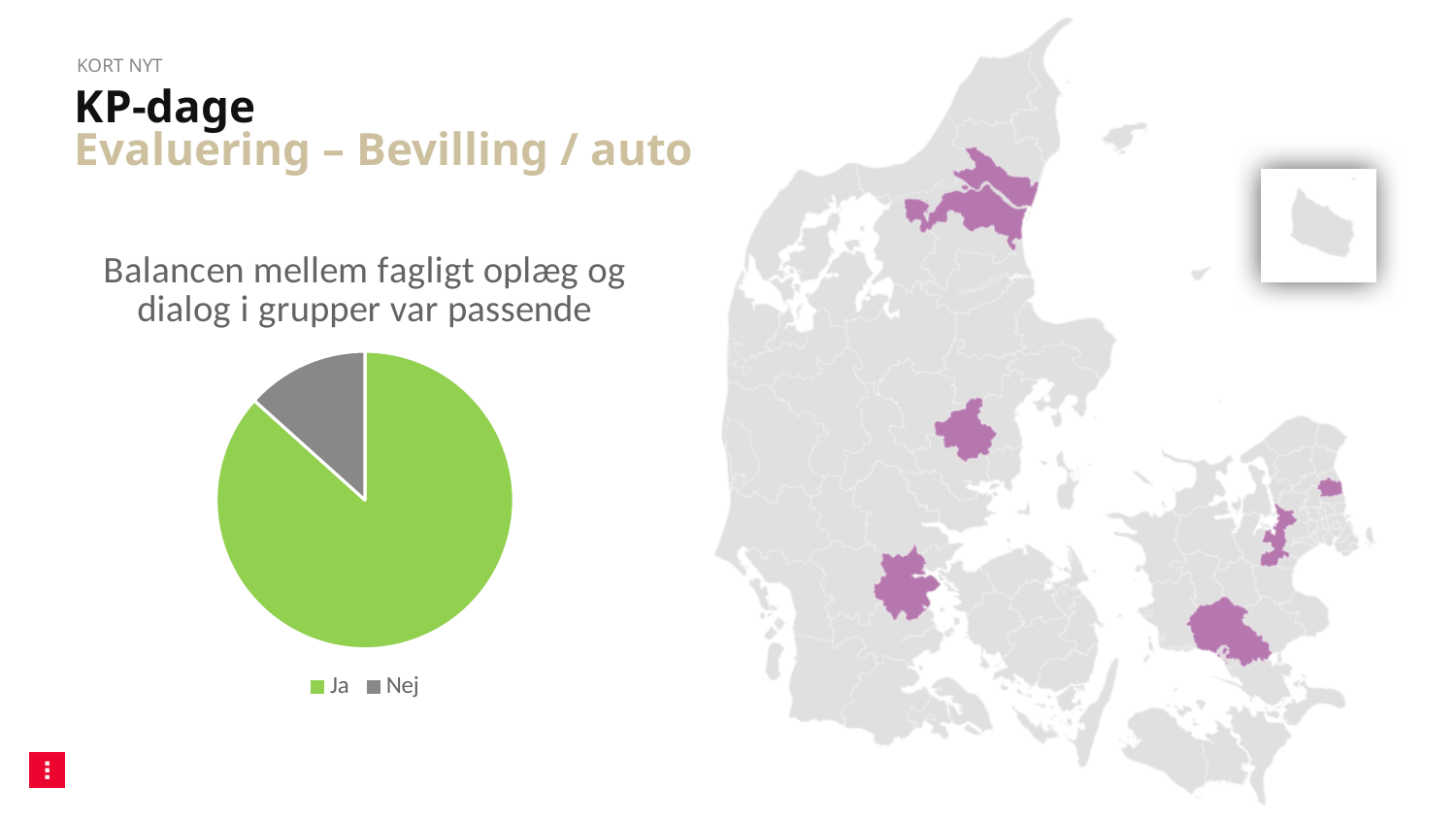
How many slices does the pie chart have? 2 What kind of chart is shown on the slide? Pie chart What colour is the Ja slice in the pie chart? Green Which slice is larger in the pie chart, Ja or Nej? Ja Which category has the largest slice in the pie chart? Ja How many entries does the legend of the pie chart list? 2 What is the title of the pie chart? Balancen mellem fagligt oplæg og dialog i grupper var passende Which category has the smallest slice in the pie chart? Nej